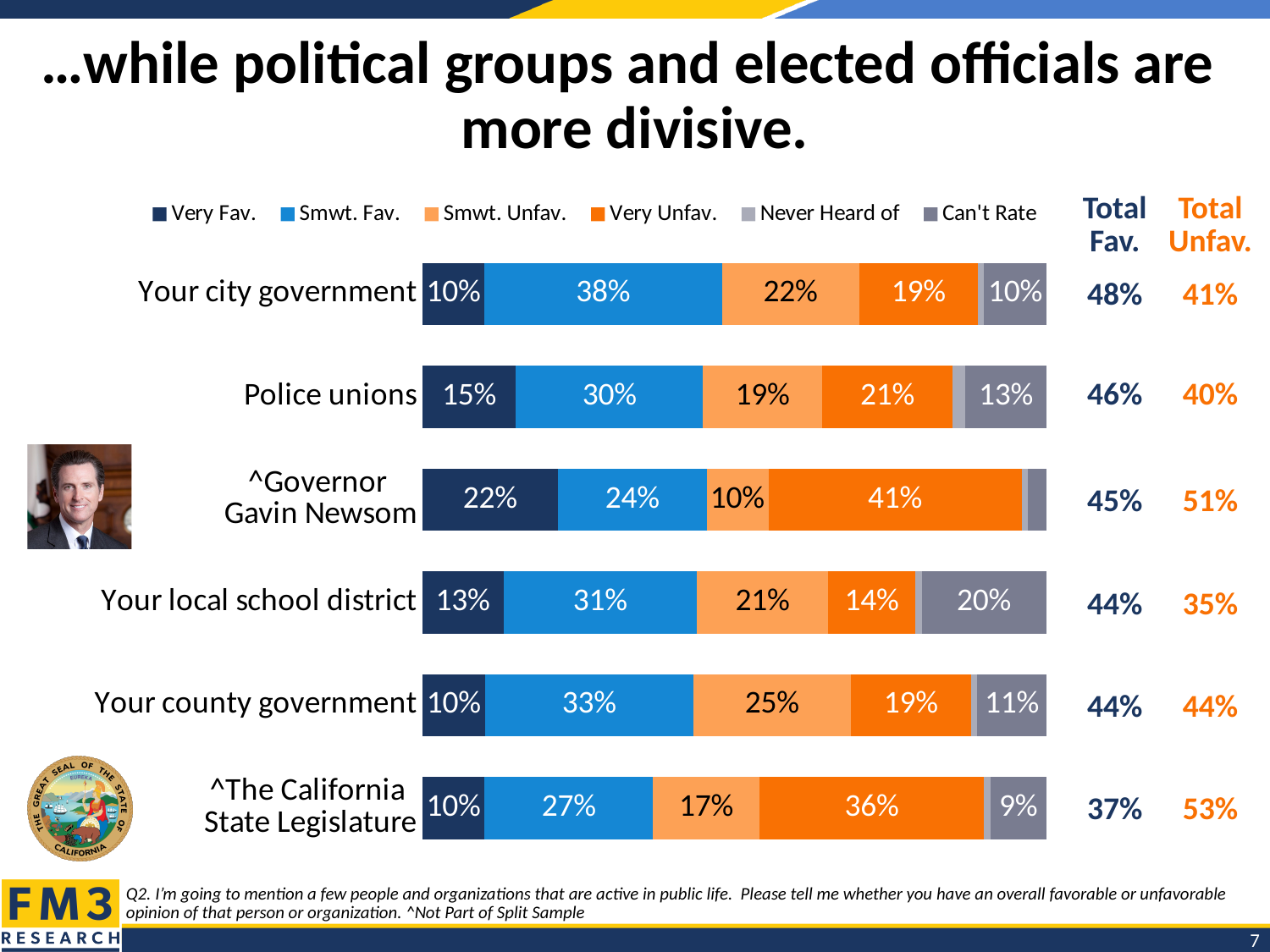
What is the Total Favorable value for Police unions? 46% How many series does the legend list? 6 Which category has the highest Total Favorable value? Your city government Which category has the highest Very Favorable value? Governor Gavin Newsom What is the Total Unfavorable value for The California State Legislature? 53% What is the Somewhat Favorable (Smwt. Fav.) value for Your city government? 38% What kind of chart is shown on the slide? Stacked bar chart Which category has the lowest Total Favorable value? The California State Legislature How many categories (people or organizations) are shown in the chart? 6 What percentage of respondents have a Very Unfavorable opinion of Governor Gavin Newsom? 41% Which has a larger Very Unfavorable value: Governor Gavin Newsom or The California State Legislature? Governor Gavin Newsom For The California State Legislature, how many percentage points higher is Total Unfavorable than Total Favorable? 16 percentage points